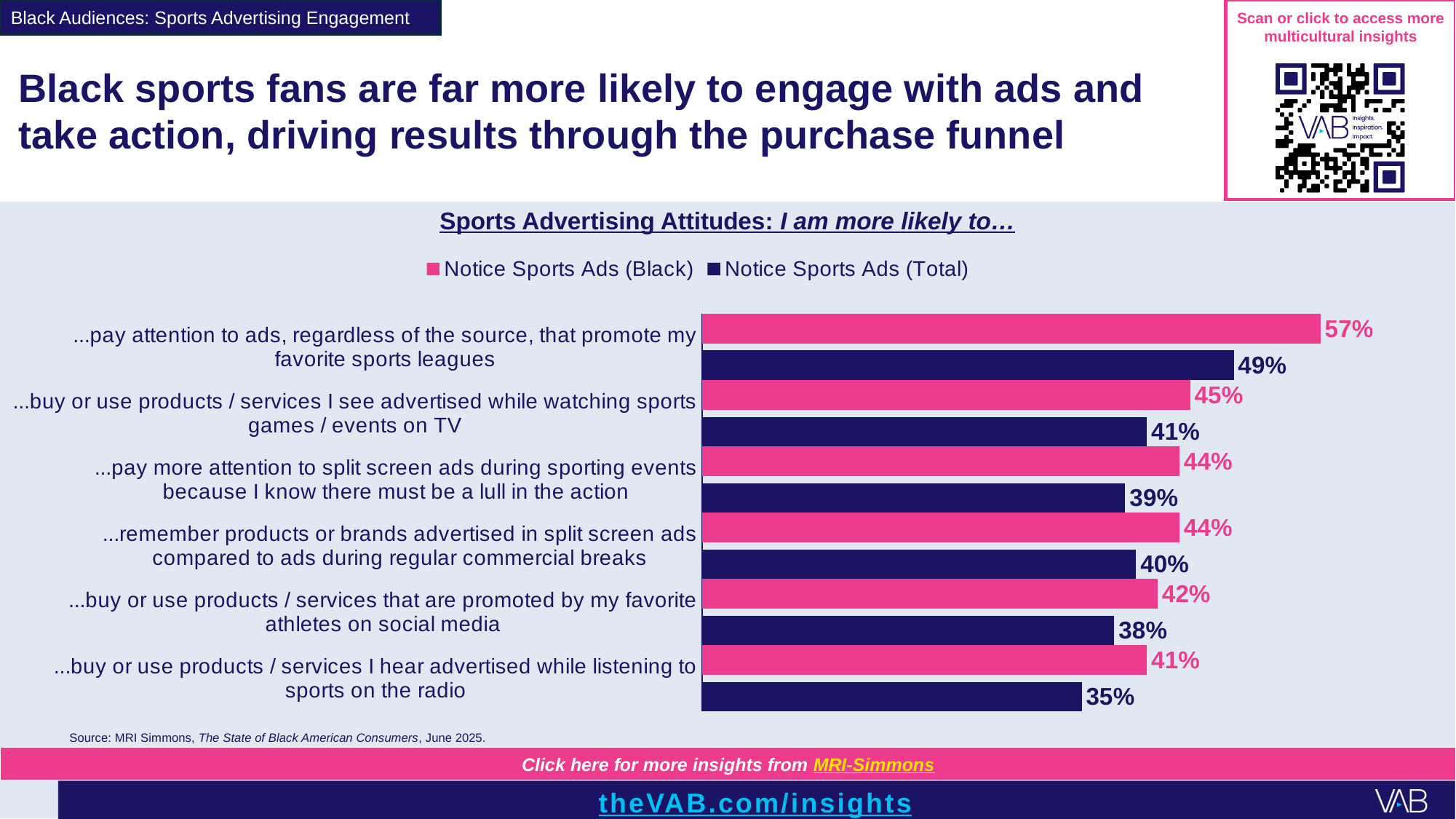
What is the value for Notice Sports Ads (Black) for '...pay attention to ads, regardless of the source, that promote my favorite sports leagues'? 57% What colour are the Notice Sports Ads (Black) bars? Pink What is the difference between the Black and Total values for '...pay attention to ads, regardless of the source, that promote my favorite sports leagues'? 8% What is the difference between the Black and Total values for '...buy or use products / services I hear advertised while listening to sports on the radio'? 6% What is the value for Notice Sports Ads (Total) for '...buy or use products / services I see advertised while watching sports games / events on TV'? 41% Which category has the highest value for Notice Sports Ads (Black)? ...pay attention to ads, regardless of the source, that promote my favorite sports leagues For '...pay more attention to split screen ads during sporting events because I know there must be a lull in the action', which is larger: the Black value or the Total value? Black How many series does the legend list? 2 What is the value for Notice Sports Ads (Total) for '...buy or use products / services I hear advertised while listening to sports on the radio'? 35% Which category has the lowest value for Notice Sports Ads (Total)? ...buy or use products / services I hear advertised while listening to sports on the radio What kind of chart is shown on the slide? Bar chart How many categories are shown in the chart? 6